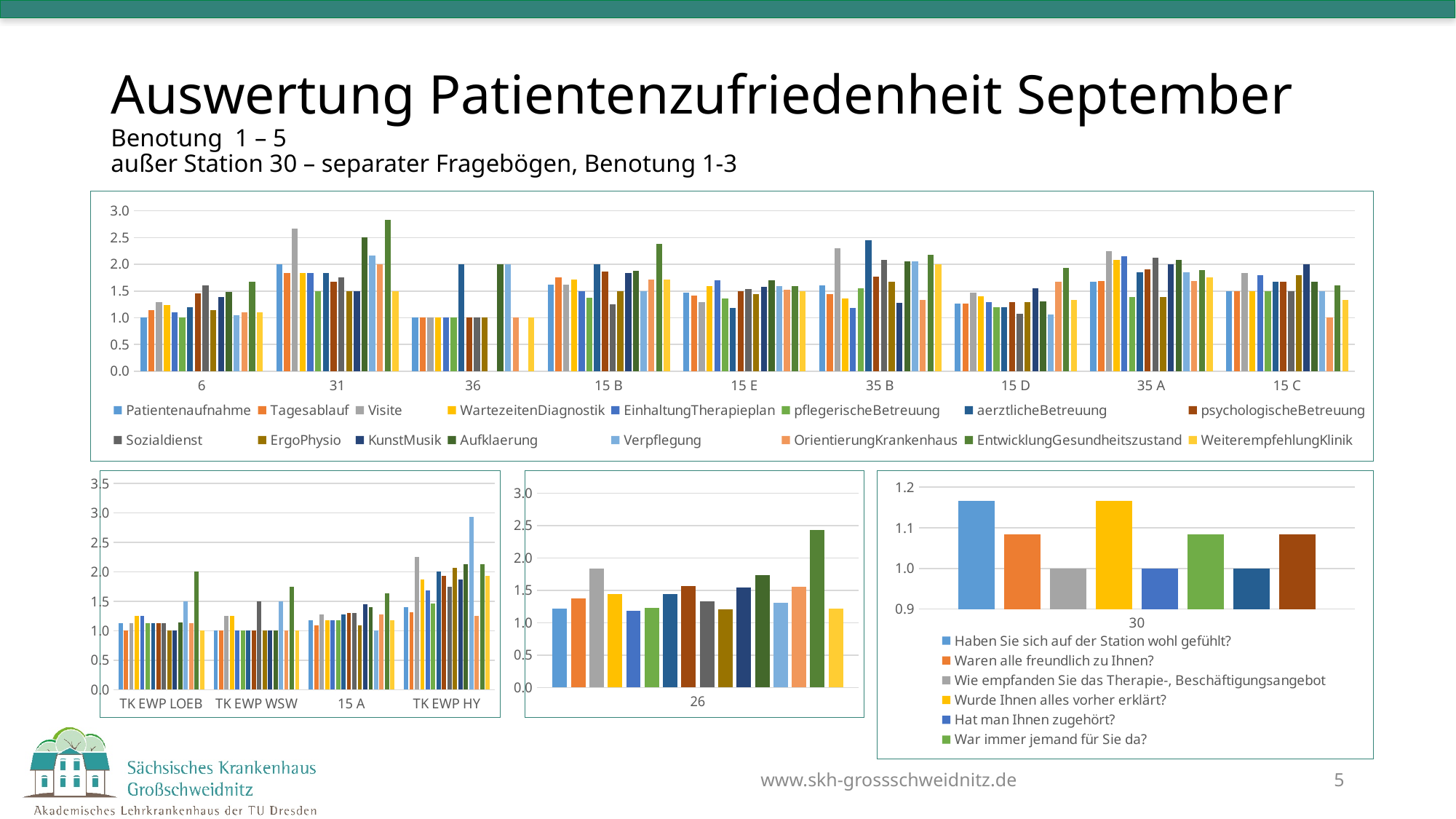
In the large top chart, is the EinhaltungTherapieplan value for station 35 B greater or less than 2.0? less In the large top chart, how many series does the legend list? 16 In the bottom-right chart (station 30), what is the value for 'Wie empfanden Sie das Therapie-, Beschäftigungsangebot'? 1.0 In the large top chart, is the Visite value for station 31 greater or less than 2.5? greater In the large top chart, which station has the tallest bar overall? 31 In the bottom-right chart (station 30), which is larger: 'Haben Sie sich auf der Station wohl gefühlt?' or 'Hat man Ihnen zugehört?'? Haben Sie sich auf der Station wohl gefühlt? In the large top chart, how many stations are shown on the x axis? 9 What kind of chart is the large chart at the top of the slide? bar chart In the bottom-left chart, how many categories are shown on the x axis? 4